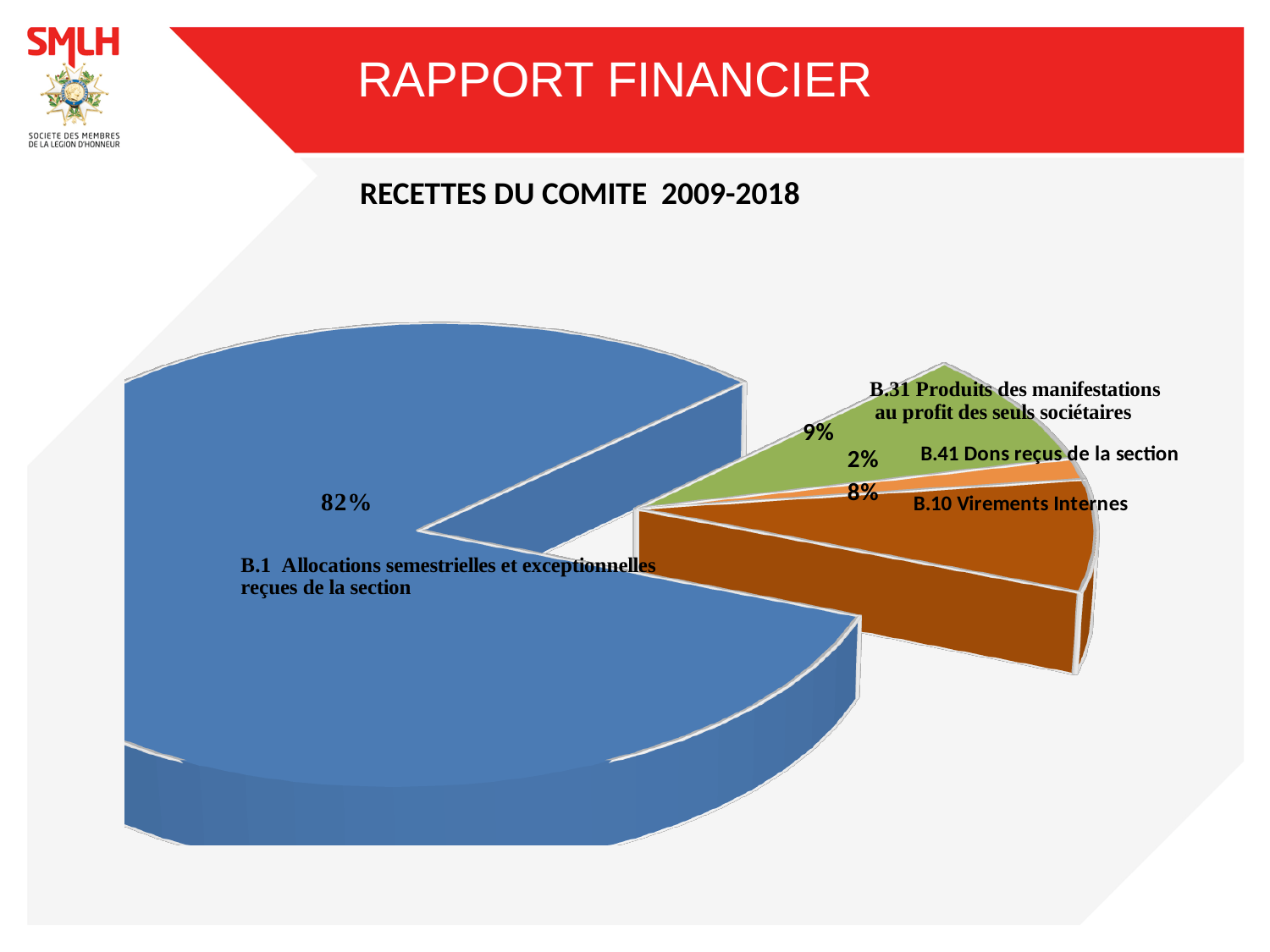
What share of the pie is B.31 Produits des manifestations au profit des seuls sociétaires? 9% What share of the pie is B.1 Allocations semestrielles et exceptionnelles reçues de la section? 82% Which category has the largest share of the pie? B.1 Allocations semestrielles et exceptionnelles reçues de la section How many slices does the pie chart have? 4 What share of the pie is B.10 Virements Internes? 8% What is the title of the chart? RECETTES DU COMITE 2009-2018 What is the difference in percentage points between the share for B.1 Allocations semestrielles et exceptionnelles reçues de la section and the share for B.31 Produits des manifestations au profit des seuls sociétaires? 73 Which is larger, the share for B.31 Produits des manifestations au profit des seuls sociétaires or the share for B.10 Virements Internes? B.31 Produits des manifestations au profit des seuls sociétaires Which category has the smallest share of the pie? B.41 Dons reçus de la section What colour is the slice for B.1 Allocations semestrielles et exceptionnelles reçues de la section? Blue What kind of chart is shown on the slide? Pie chart